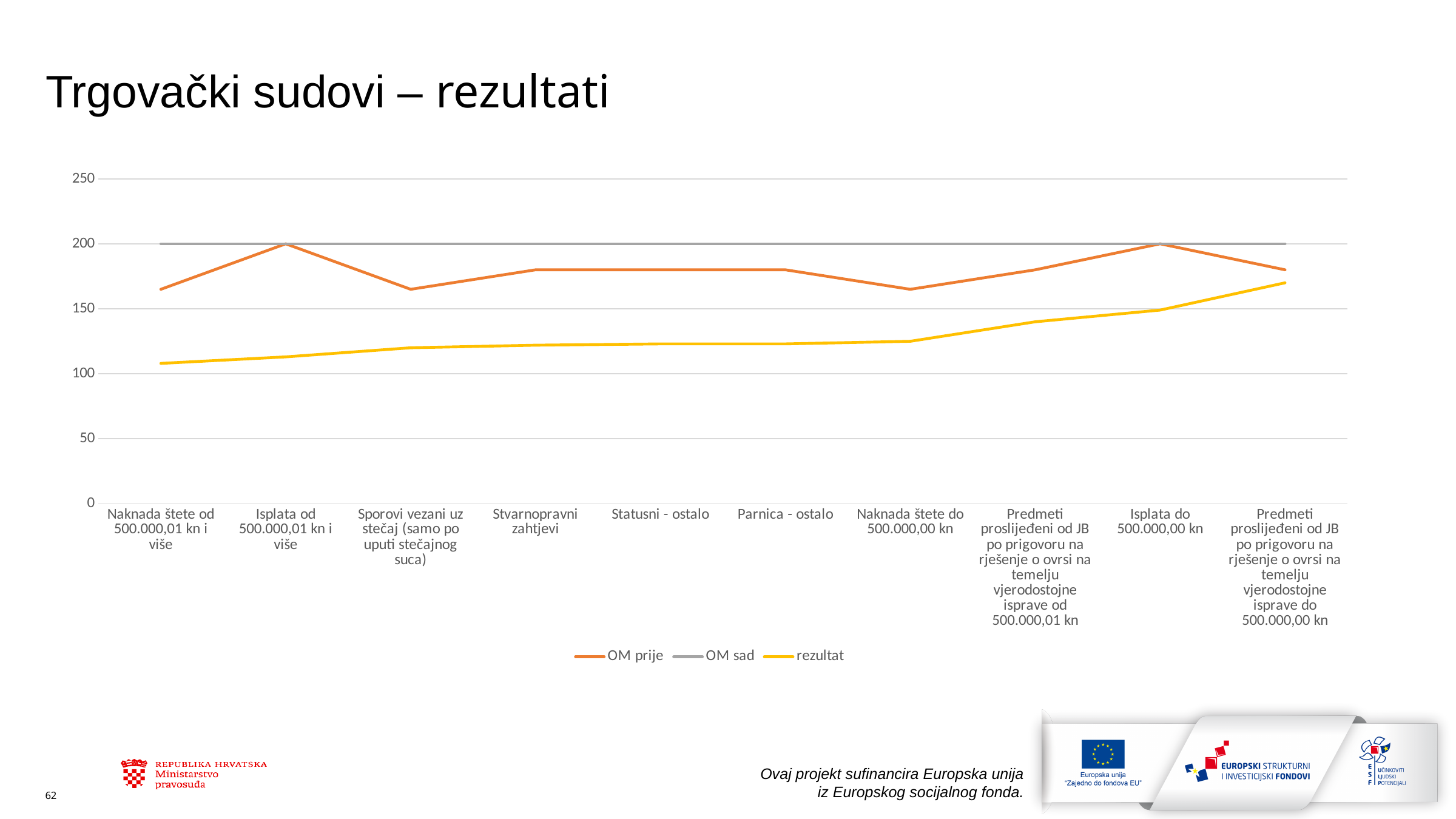
For Stvarnopravni zahtjevi, which is larger: OM sad or rezultat? OM sad Which category has the lowest rezultat value? Naknada štete od 500.000,01 kn i više Is the rezultat value for Naknada štete od 500.000,01 kn i više greater or less than 150? less What is the value of OM prije for Isplata od 500.000,01 kn i više? 200 What kind of chart is shown on the slide? line chart Is the rezultat value for Predmeti proslijeđeni od JB po prigovoru na rješenje o ovrsi na temelju vjerodostojne isprave do 500.000,00 kn greater or less than 150? greater Which category has the highest rezultat value? Predmeti proslijeđeni od JB po prigovoru na rješenje o ovrsi na temelju vjerodostojne isprave do 500.000,00 kn How many categories are plotted along the x axis? 10 What is the value of OM sad for Statusni - ostalo? 200 How many series does the legend list? 3 Is the OM prije value for Sporovi vezani uz stečaj (samo po uputi stečajnog suca) greater or less than 150? greater Does the rezultat series generally rise or fall from left to right along the x axis? rise